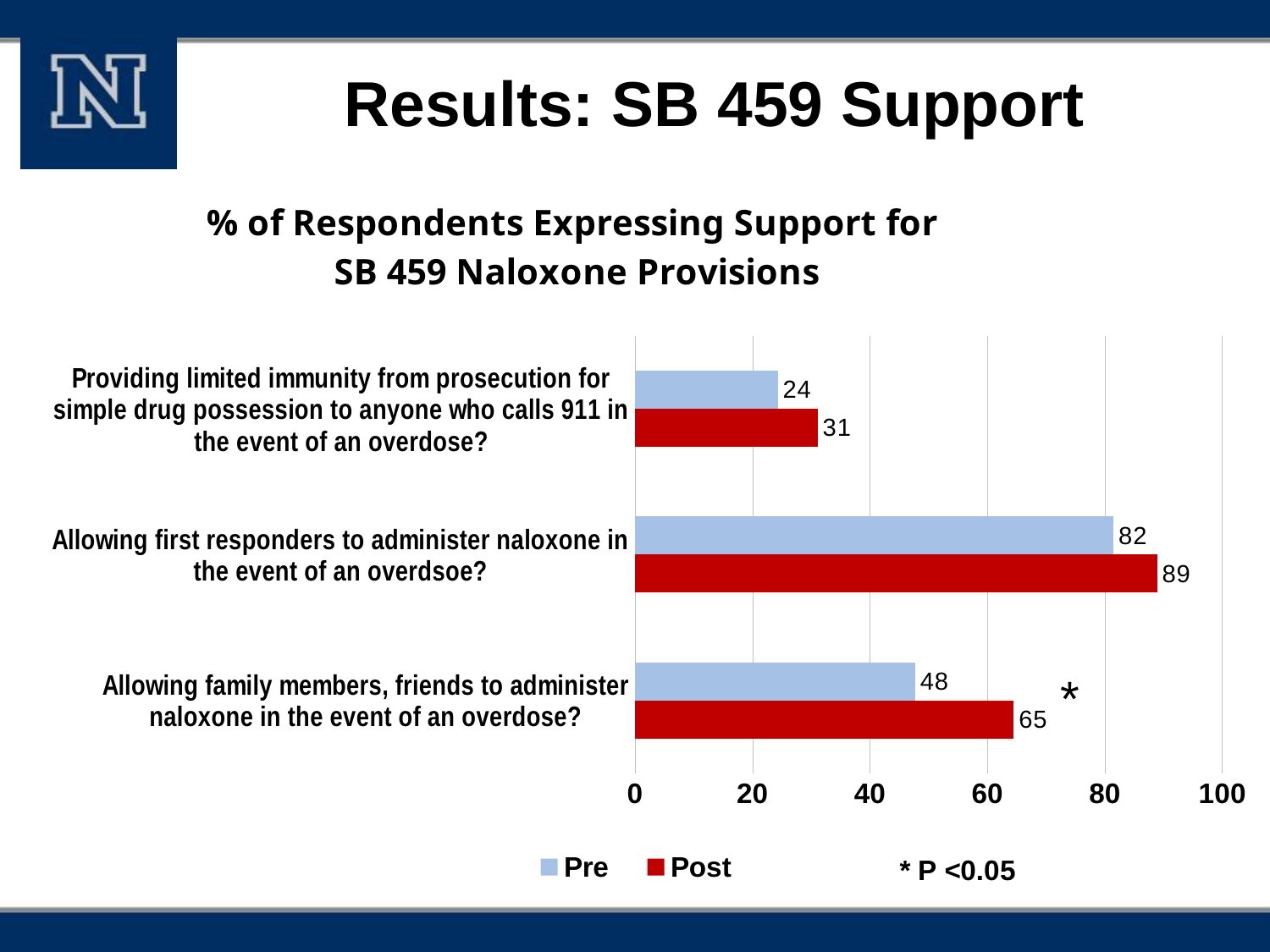
Which is larger for the limited immunity provision, the Pre value or the Post value? Post What is the difference between the Post and Pre values for allowing family members, friends to administer naloxone? 17 Which category has the highest Post value? Allowing first responders to administer naloxone in the event of an overdose? What is the Post value for providing limited immunity from prosecution for simple drug possession to anyone who calls 911 in the event of an overdose? 31 Is the Pre value for allowing family members, friends to administer naloxone greater or less than 60? less What kind of chart is shown on the slide? Bar chart Which category has the lowest Pre value? Providing limited immunity from prosecution for simple drug possession to anyone who calls 911 in the event of an overdose? What is the Post value for allowing family members, friends to administer naloxone in the event of an overdose? 65 How many series does the legend list? 2 How many categories are shown in the chart? 3 What is the difference between the Post and Pre values for allowing first responders to administer naloxone? 7 What is the Pre value for allowing first responders to administer naloxone in the event of an overdose? 82